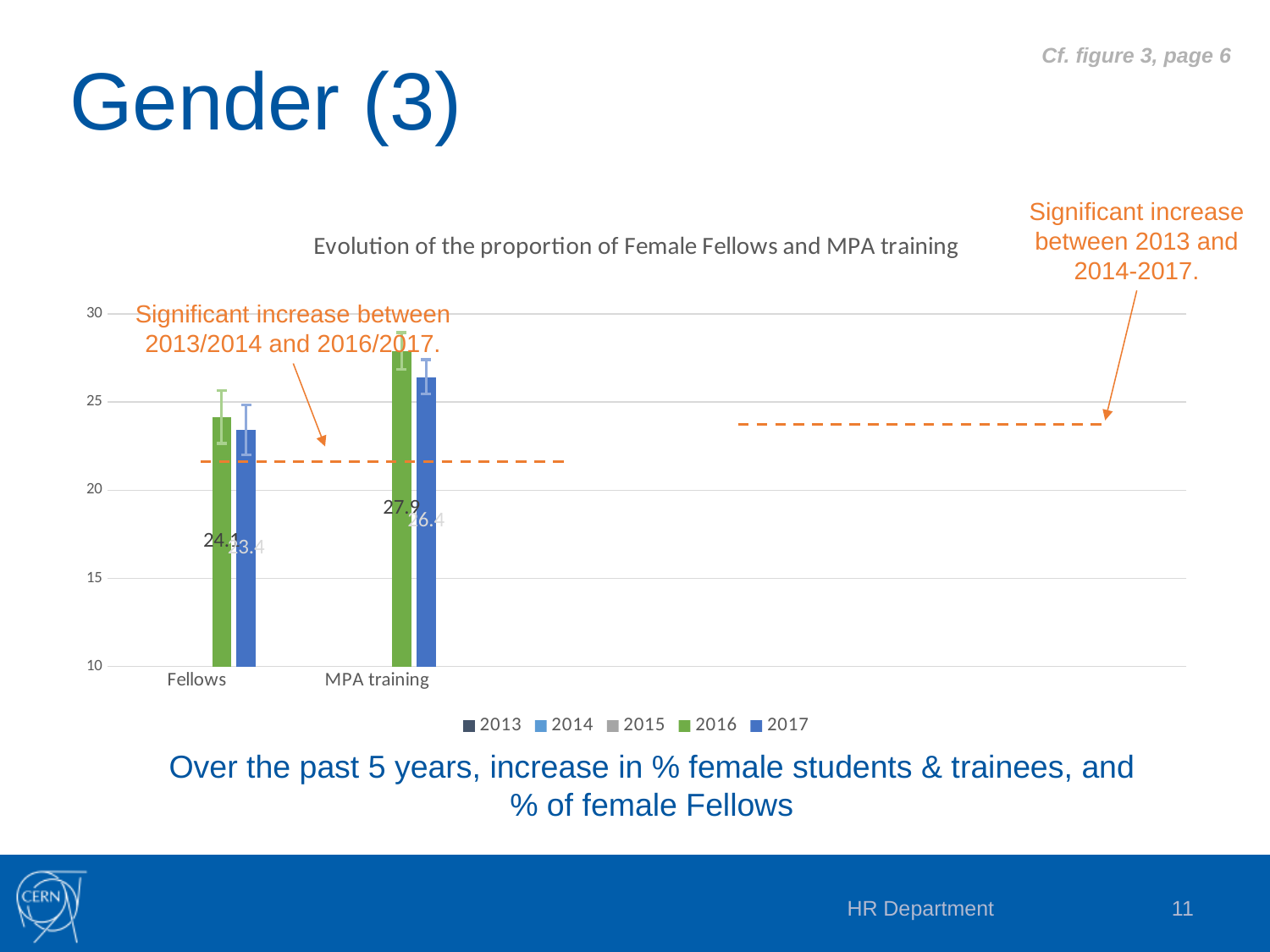
Is the 2017 value for MPA training greater or less than 25? greater How many categories are shown on the x axis of the chart? 2 What kind of chart is shown on the slide? bar chart What is the 2016 value for MPA training? 27.9 What is the 2016 value for Fellows? 24.1 What colour are the 2016 bars in the chart? green What is the title of the chart? Evolution of the proportion of Female Fellows and MPA training Which category has the higher 2016 value, Fellows or MPA training? MPA training How many series does the chart legend list? 5 What is the difference between the 2016 values for MPA training and Fellows? 3.8 For MPA training, which year has the larger value, 2016 or 2017? 2016 Is the 2017 value for Fellows greater or less than 25? less